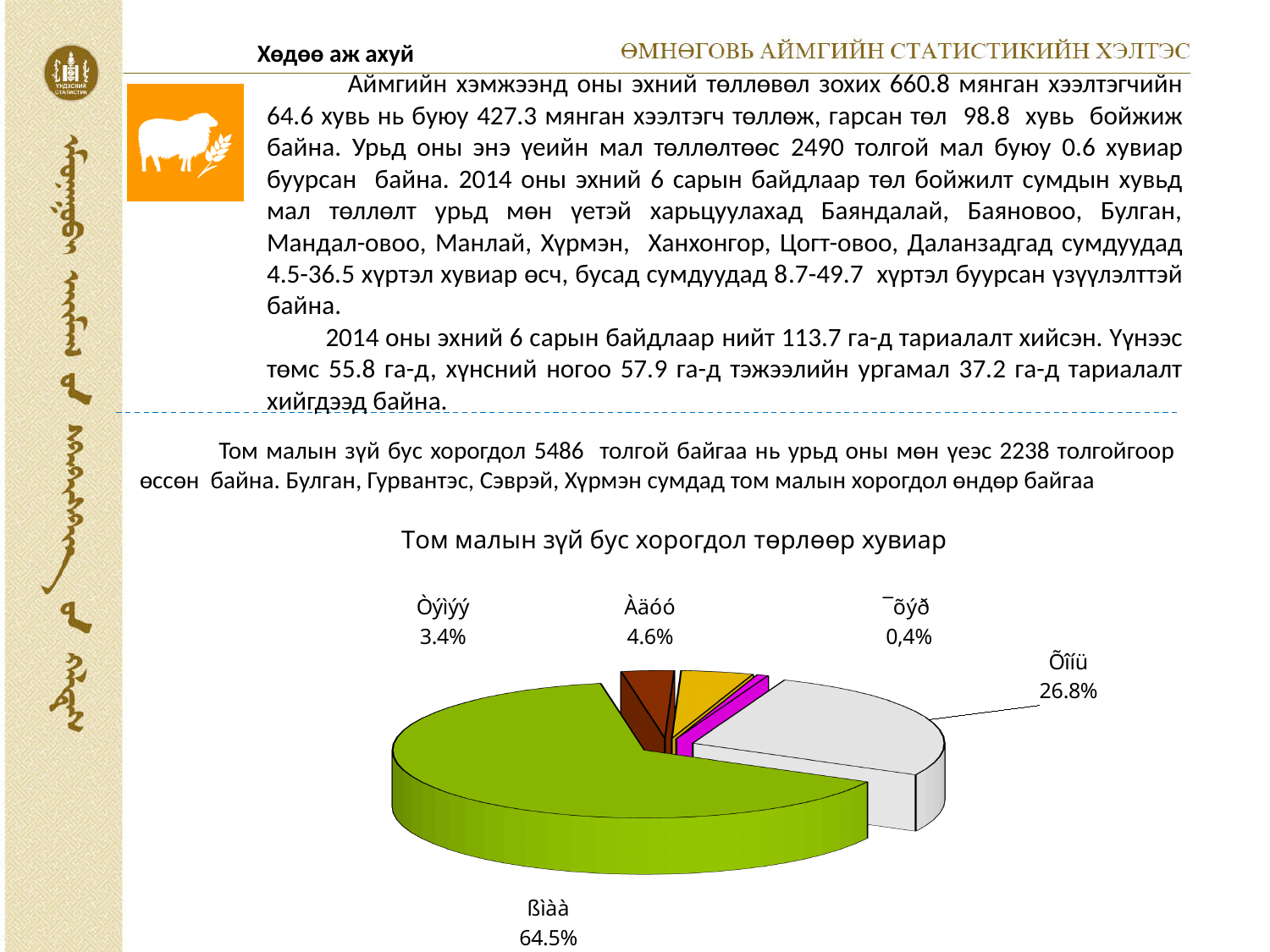
What percentage is shown for the slice labelled Òýìýý? 3.4% Which slice is larger, Àäóó or Òýìýý? Àäóó What percentage does the large green slice of the pie represent? 64.5% Which slice of the pie chart is the largest? ßìàà (64.5%) What percentage is shown for the slice labelled Àäóó? 4.6% What is the difference in percentage points between the Àäóó slice and the Òýìýý slice? 1.2 What is the title of the chart on the slide? Том малын зүй бус хорогдол төрлөөр хувиар How many slices does the pie chart have? 5 What percentage is shown for the slice labelled Õîíü? 26.8% What kind of chart is shown on the slide? pie chart What is the difference in percentage points between the ßìàà slice and the Õîíü slice? 37.7 Which slice of the pie chart is the smallest? ¯õýð (0,4%)